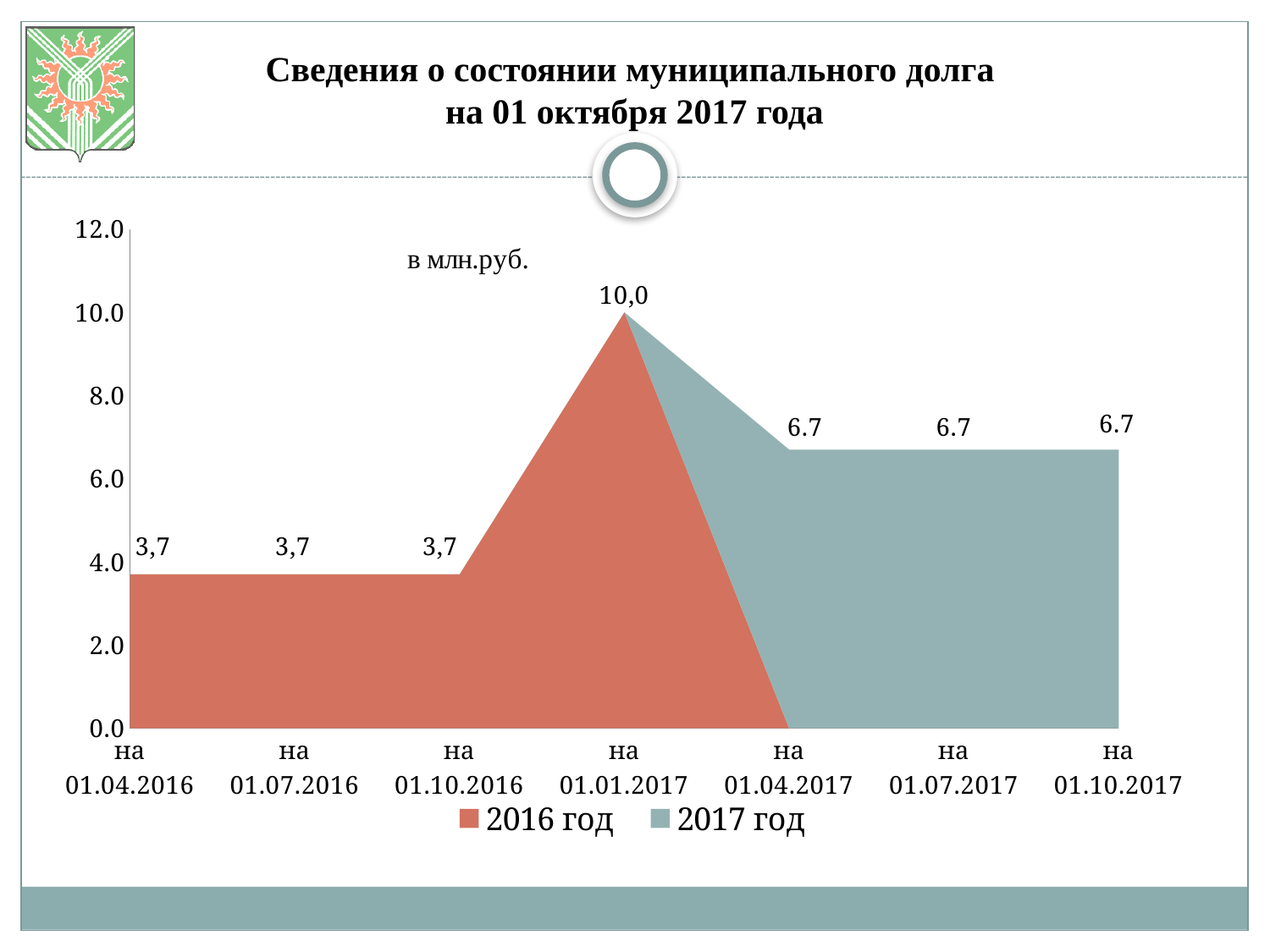
How many series does the legend list? 2 Which date has the highest value? на 01.01.2017 What is the value for на 01.10.2017? 6.7 What unit is stated on the chart? в млн.руб. What is the difference between the values for на 01.01.2017 and на 01.04.2017? 3.3 How many dates are shown on the x axis? 7 What kind of chart is shown on the slide? area chart What is the value for на 01.04.2016? 3,7 What is the value for на 01.07.2017? 6.7 Which is larger, the value for на 01.10.2016 or the value for на 01.04.2017? на 01.04.2017 What is the value for на 01.01.2017? 10,0 What is the difference between the values for на 01.01.2017 and на 01.10.2016? 6.3